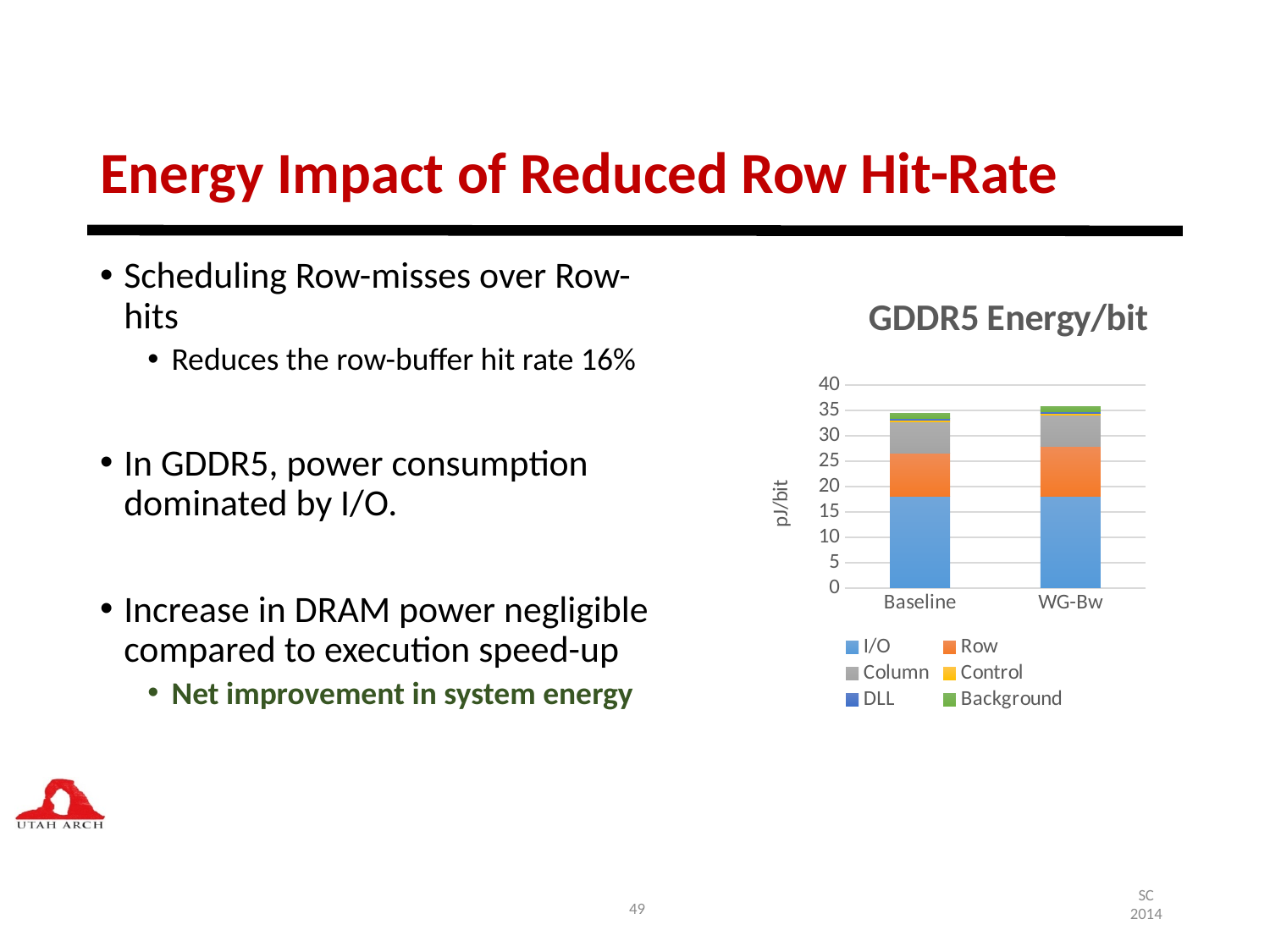
Is the Row segment larger for Baseline or for WG-Bw? WG-Bw How many categories are shown on the x axis of the chart? 2 What is the label on the vertical axis of the chart? pJ/bit Is the I/O value for Baseline greater or less than 15? greater Is the total stacked value for Baseline greater or less than 30? greater What is the title of the chart? GDDR5 Energy/bit What kind of chart is shown on the slide? stacked bar chart Is the I/O value for WG-Bw greater or less than 20? less Which series forms the largest segment of the Baseline bar? I/O How many series does the chart legend list? 6 Which category has the taller total stacked bar, Baseline or WG-Bw? WG-Bw